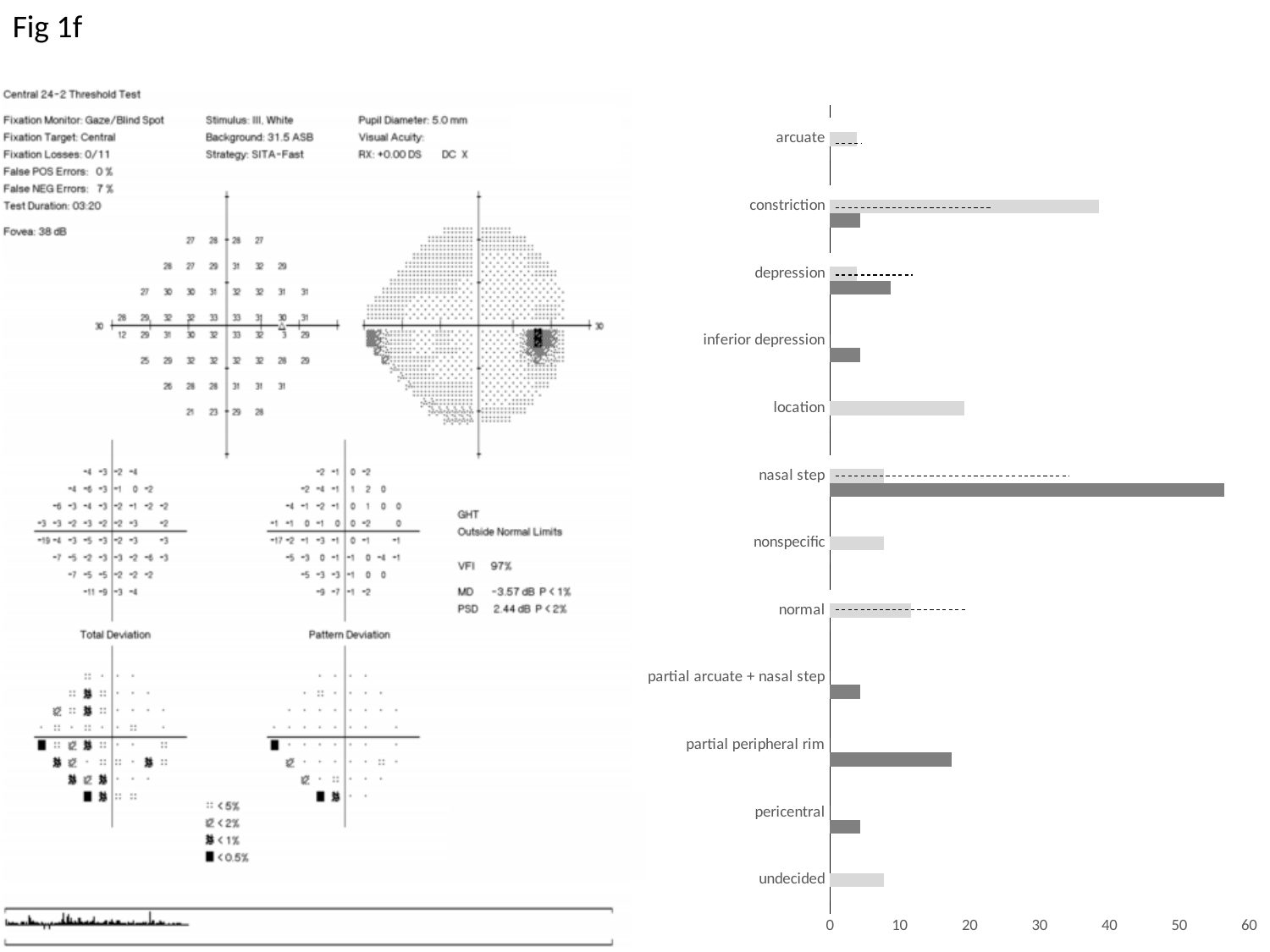
Which has a longer bar: location or normal? location Is the value of the light grey bar for constriction greater or less than 30? greater What is the highest value shown on the horizontal axis of the bar chart? 60 Which has a longer bar: partial peripheral rim or undecided? partial peripheral rim What kind of chart is shown on the right side of the slide? bar chart Is the value of the bar for location greater or less than 10? greater What is the label of the first category at the top of the bar chart? arcuate Which category has the longest bar in the bar chart? nasal step Is the value of the bar for partial peripheral rim greater or less than 20? less How many categories are listed on the vertical axis of the bar chart? 12